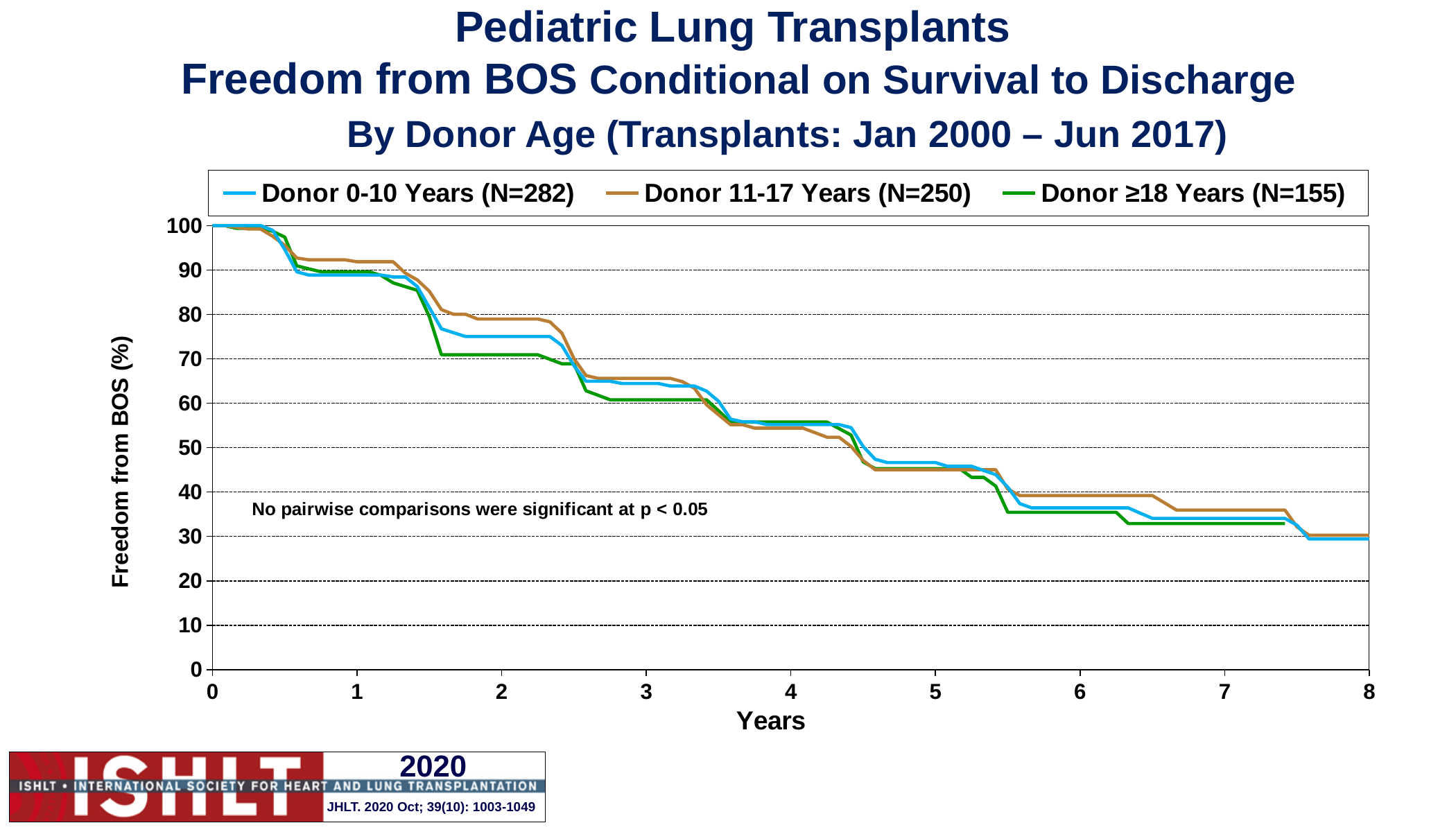
Is the value for Donor 0-10 Years at year 2 greater or less than 70? greater What kind of chart is shown on the slide? line chart Is the value for Donor ≥18 Years at year 7 greater or less than 40? less What is the label of the y axis? Freedom from BOS (%) Do the values for Donor 0-10 Years rise or fall as years increase? fall Is the value for Donor 11-17 Years at year 4 greater or less than 50? greater What is the N for the Donor 0-10 Years series shown in the legend? N=282 At year 2, which series has the lowest freedom from BOS? Donor ≥18 Years What is the value for Donor 11-17 Years at year 0? 100 At year 2, which is larger: the value for Donor 11-17 Years or Donor ≥18 Years? Donor 11-17 Years How many series does the legend list? 3